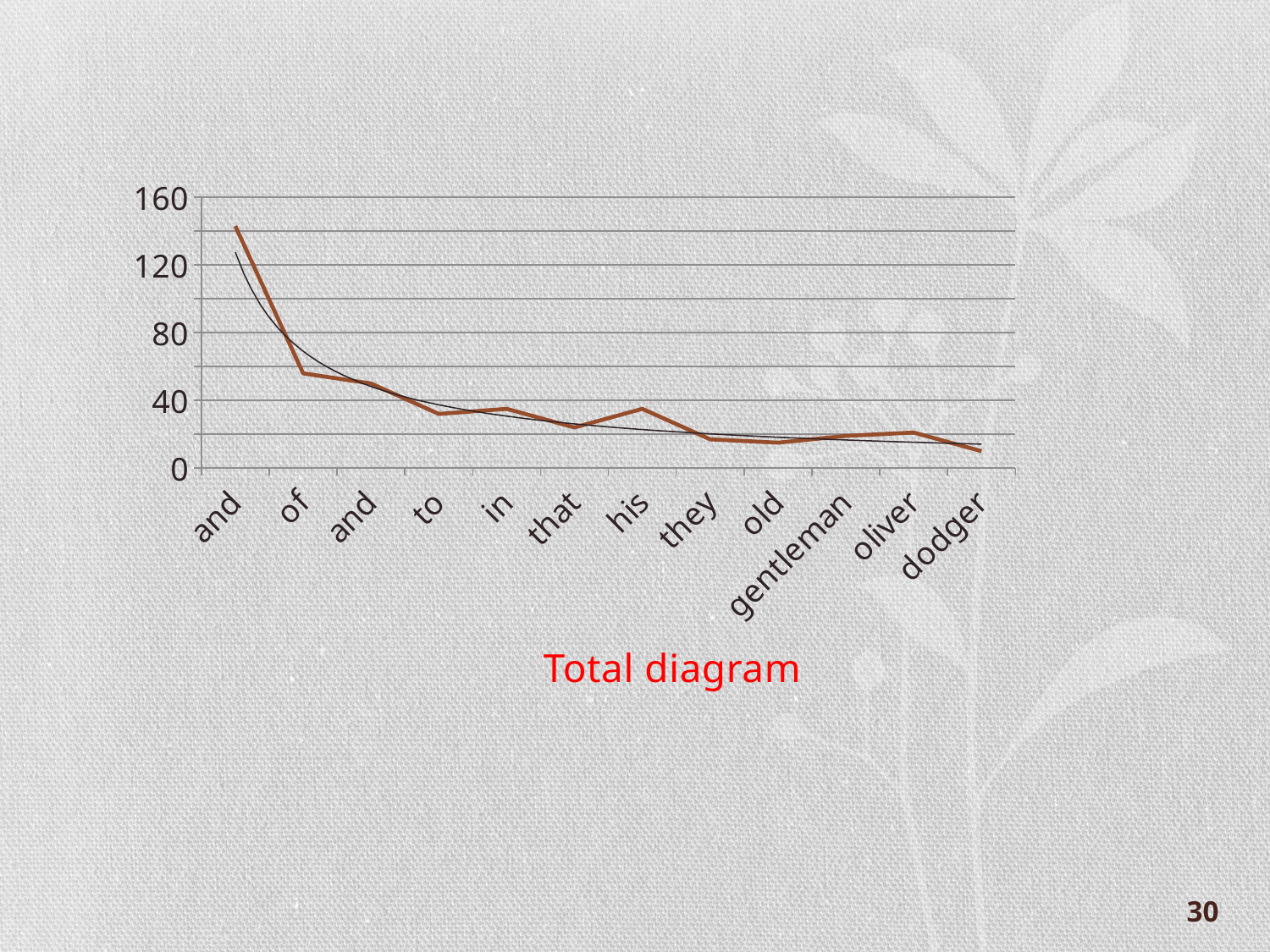
Is the value for "of" greater or less than 40? greater What is the caption shown in red below the chart? Total diagram Is the value for "dodger" greater or less than 40? less Do the values generally rise or fall from left to right along the x axis? fall Which category has the lowest value? dodger What kind of chart is shown on the slide? line chart Is the value for "of" greater or less than 80? less Which has the larger value, "of" or "to"? of How many categories are plotted along the x axis? 12 Which category has the highest value? and (the first category)